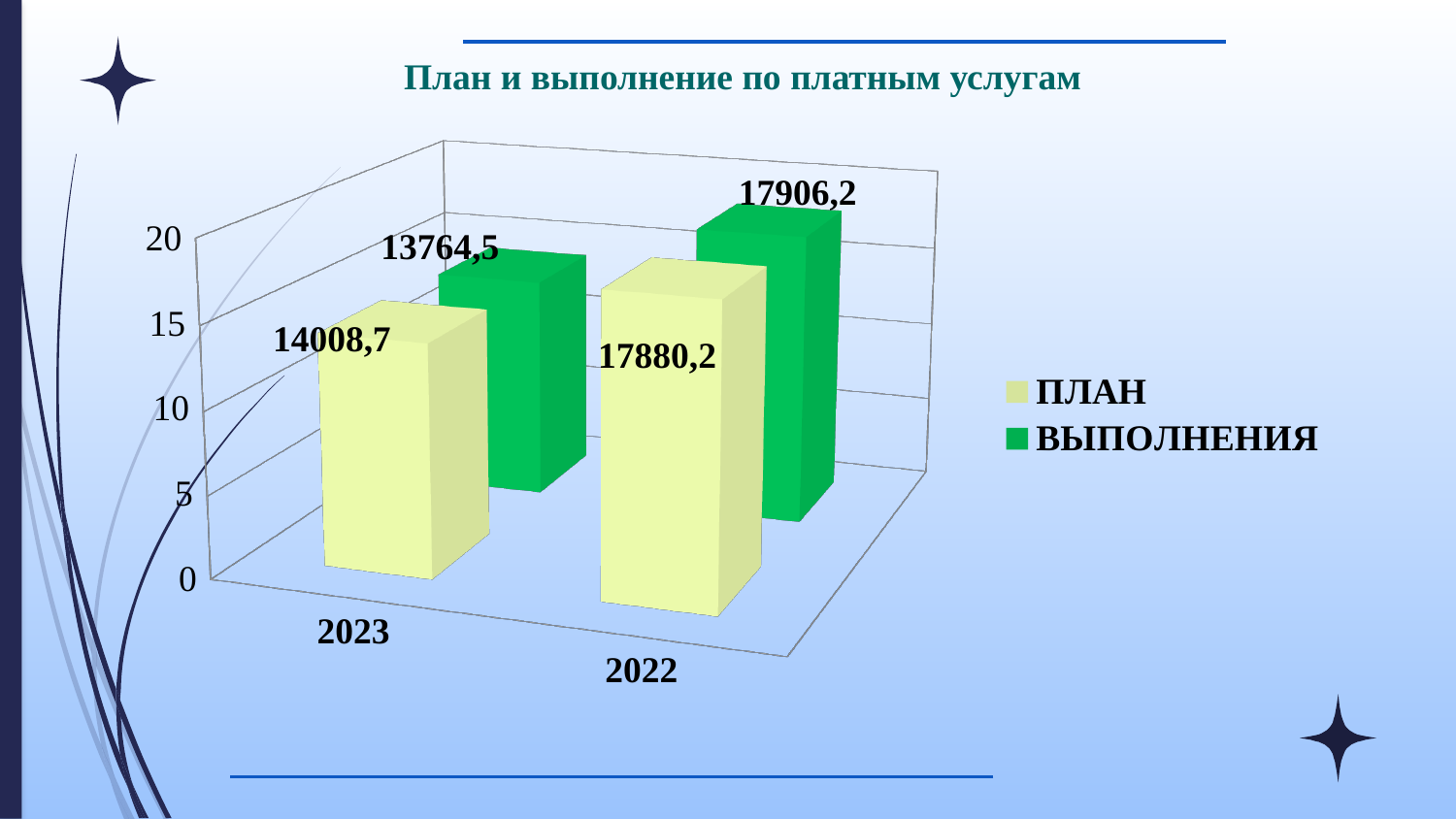
Which bar has the lowest value on the chart? ВЫПОЛНЕНИЯ for 2023 (13764,5) What is the difference between the ПЛАН values for 2022 and 2023? 3871,5 How many series does the legend list? 2 How many years (categories) are shown on the x axis? 2 What is the ПЛАН value for 2023? 14008,7 What is the difference between the ПЛАН and ВЫПОЛНЕНИЯ values for 2023? 244,2 What is the ВЫПОЛНЕНИЯ value for 2022? 17906,2 What is the ВЫПОЛНЕНИЯ value for 2023? 13764,5 What is the ПЛАН value for 2022? 17880,2 What type of chart is shown on the slide? Bar chart Which year has the higher ПЛАН value? 2022 For 2022, which is larger: ПЛАН or ВЫПОЛНЕНИЯ? ВЫПОЛНЕНИЯ